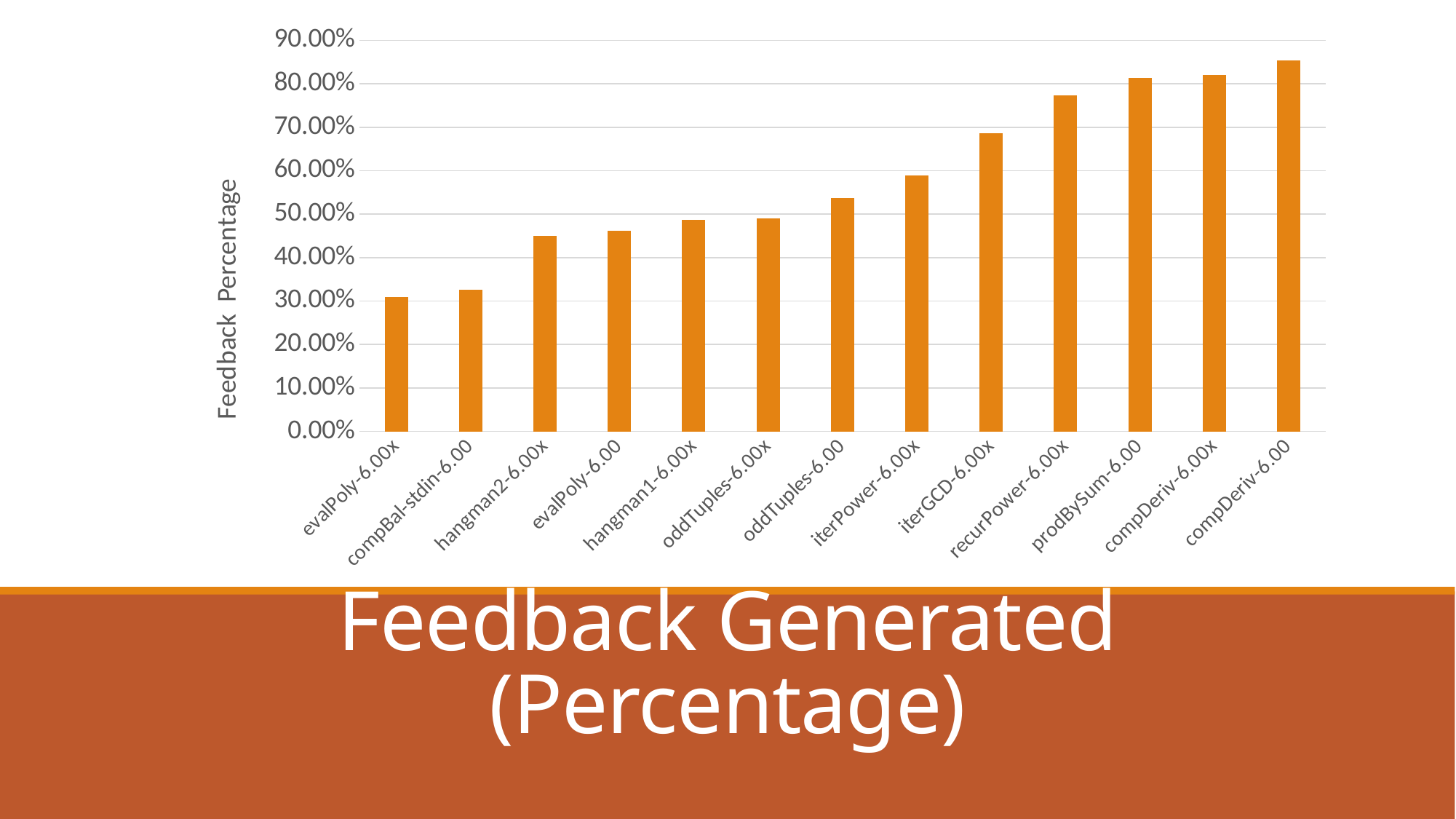
Is the value for compDeriv-6.00 greater or less than 80.00%? greater Which has a larger feedback percentage, hangman2-6.00x or oddTuples-6.00? oddTuples-6.00 Is the value for iterGCD-6.00x greater or less than 60.00%? greater Which has a larger feedback percentage, iterPower-6.00x or iterGCD-6.00x? iterGCD-6.00x Is the value for evalPoly-6.00x greater or less than 40.00%? less Do the bar values rise or fall from left to right along the x axis? rise What kind of chart is shown on the slide? bar chart What is the label of the vertical axis? Feedback Percentage Which category has the highest feedback percentage? compDeriv-6.00 How many categories (bars) are plotted in the chart? 13